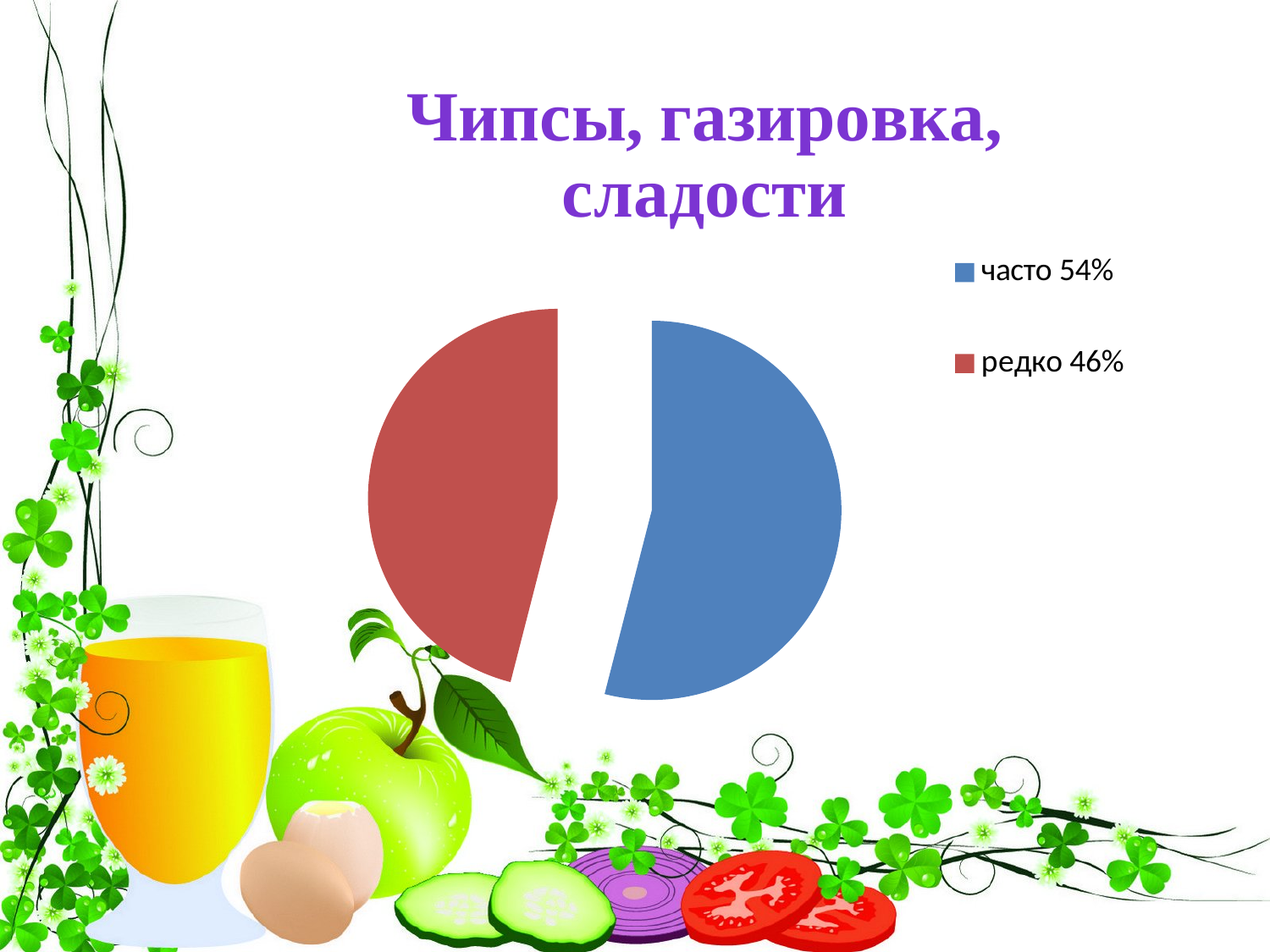
Which is larger, the "часто" slice or the "редко" slice? часто What colour is the "редко" slice? red What is the difference in percentage points between the "часто" and "редко" slices? 8 How many entries does the legend list? 2 What is the title of the slide above the chart? Чипсы, газировка, сладости How many slices does the pie chart have? 2 What share of the pie is labelled "часто"? 54% What kind of chart is shown on the slide? pie chart Which slice is the largest? часто Which slice is the smallest? редко Is the share for "часто" greater or less than 50%? greater What share of the pie is labelled "редко"? 46%